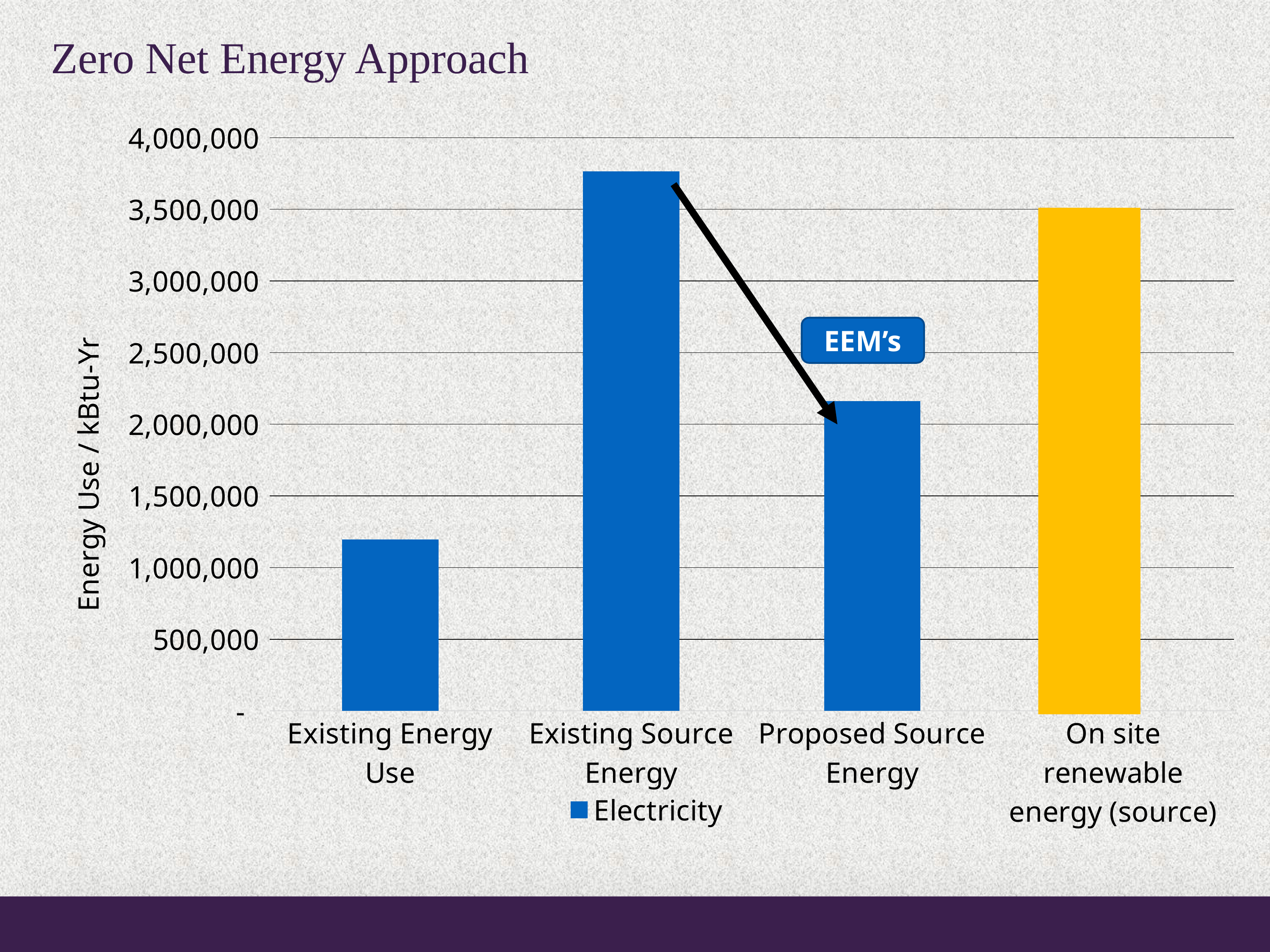
What is the label on the vertical axis of the chart? Energy Use / kBtu-Yr Is the value for Existing Source Energy greater or less than 3,500,000? greater Which is larger, the value for Existing Source Energy or the value for Proposed Source Energy? Existing Source Energy Is the value for Proposed Source Energy greater or less than 2,000,000? greater Which category has the highest bar in the chart? Existing Source Energy Which is larger, the value for Existing Energy Use or the value for Proposed Source Energy? Proposed Source Energy How many series does the chart legend list? 1 Which category has the lowest bar in the chart? Existing Energy Use How many categories are shown on the x axis of the chart? 4 Is the value for Existing Energy Use greater or less than 1,500,000? less What series name is shown in the chart legend? Electricity What kind of chart is shown on the slide? bar chart